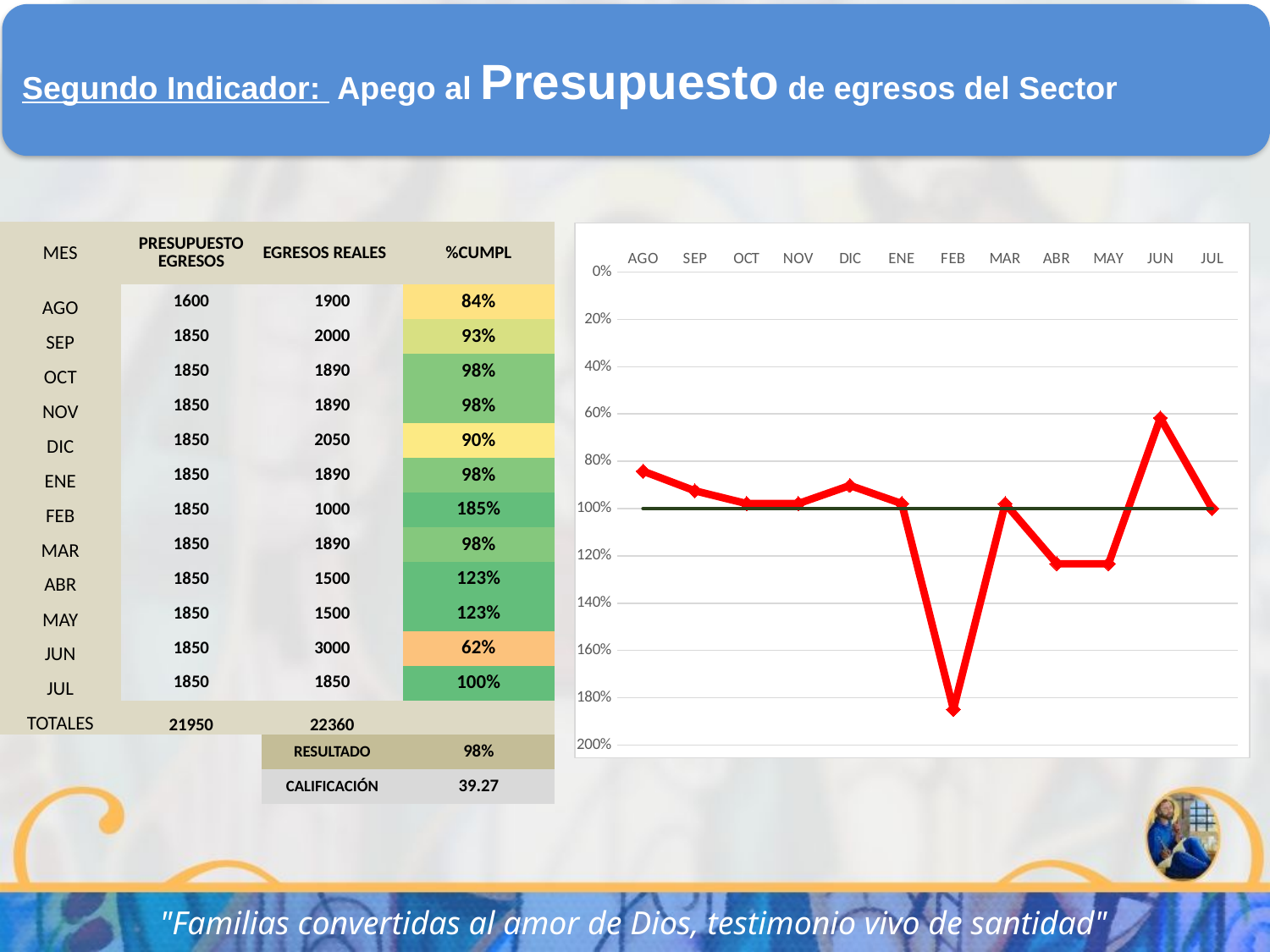
In the line chart, what is the value for JUL? 100% In the line chart, is the value for FEB greater or less than 160%? greater In the line chart, which month has the lowest value? JUN How many months are plotted along the x axis of the line chart? 12 In the line chart, what percentage is shown at the top of the vertical axis? 0% In the line chart, does the value rise or fall from MAY to JUN? fall In the line chart, which month has the highest value? FEB In the line chart, is the value for ABR greater or less than 100%? greater In the line chart, is the value for JUN greater or less than 80%? less What kind of chart is shown on the right side of the slide? line chart In the line chart, which month has the larger value, FEB or JUN? FEB